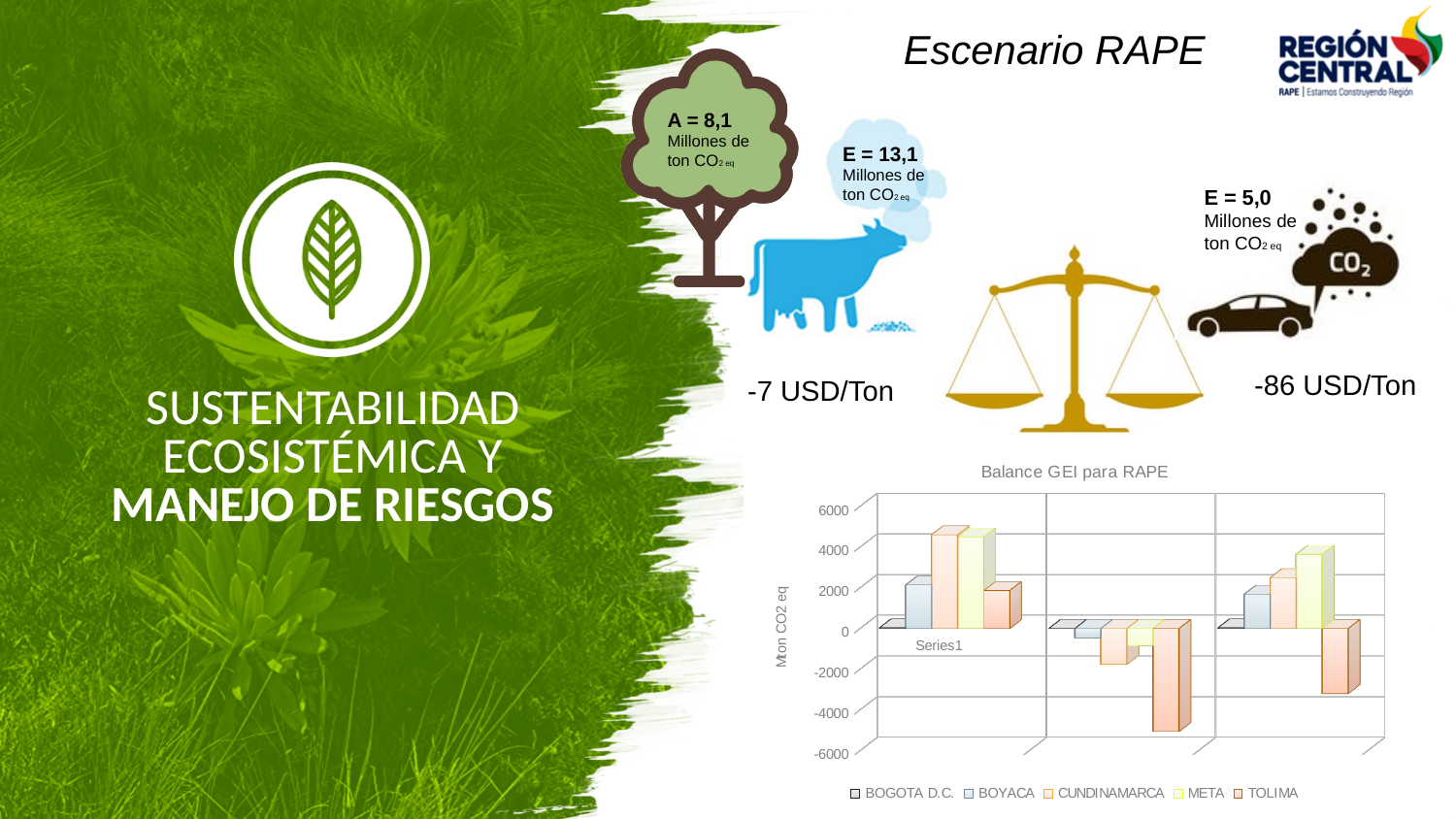
In the Series1 group, is the value for CUNDINAMARCA greater or less than 4000? greater How many series does the chart legend list? 5 In the Series1 group, which is larger, the value for META or the value for TOLIMA? META In the Series1 group, is the value for META greater or less than 2000? greater In the Series1 group, which is larger, the value for CUNDINAMARCA or the value for BOYACA? CUNDINAMARCA What kind of chart is shown on the slide? bar chart What is the label on the vertical axis of the chart? Mton CO2 eq In the Series1 group, which series has the lowest value? BOGOTA D.C. How many groups of bars are plotted in the chart? 3 What is the title of the chart on the slide? Balance GEI para RAPE In the Series1 group, is the value for BOGOTA D.C. greater or less than 2000? less